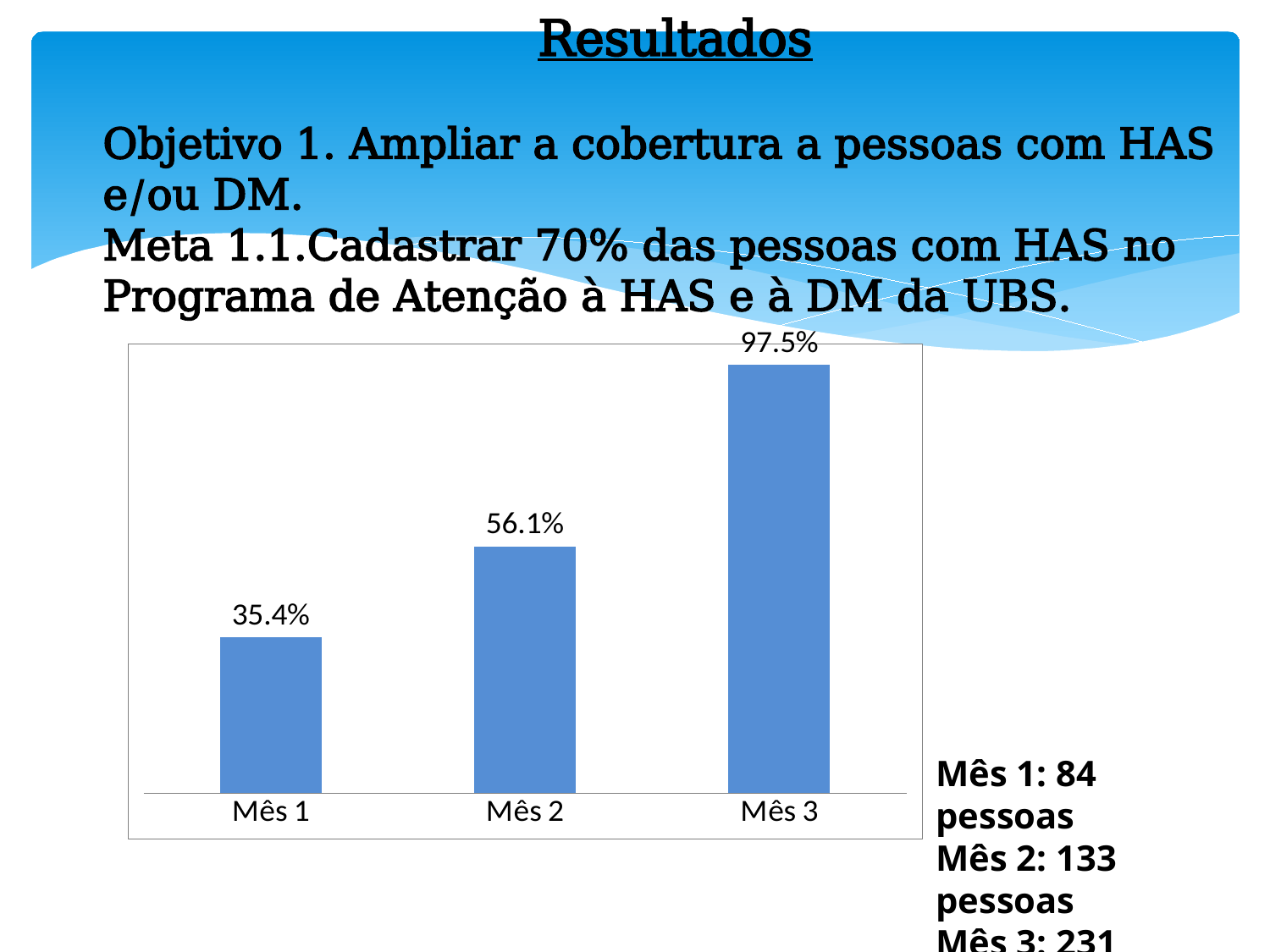
Which month has the lowest value? Mês 1 What is the difference between the values for Mês 3 and Mês 1? 62.1% What is the value for Mês 2? 56.1% What is the difference between the values for Mês 2 and Mês 1? 20.7% Do the values rise or fall from Mês 1 to Mês 3? Rise What kind of chart is shown on the slide? Bar chart What is the value for Mês 1? 35.4% What colour are the bars in the chart? Blue How many bars are shown in the chart? 3 What is the value for Mês 3? 97.5% Which month has the highest value? Mês 3 Which is larger, the value for Mês 2 or the value for Mês 3? Mês 3